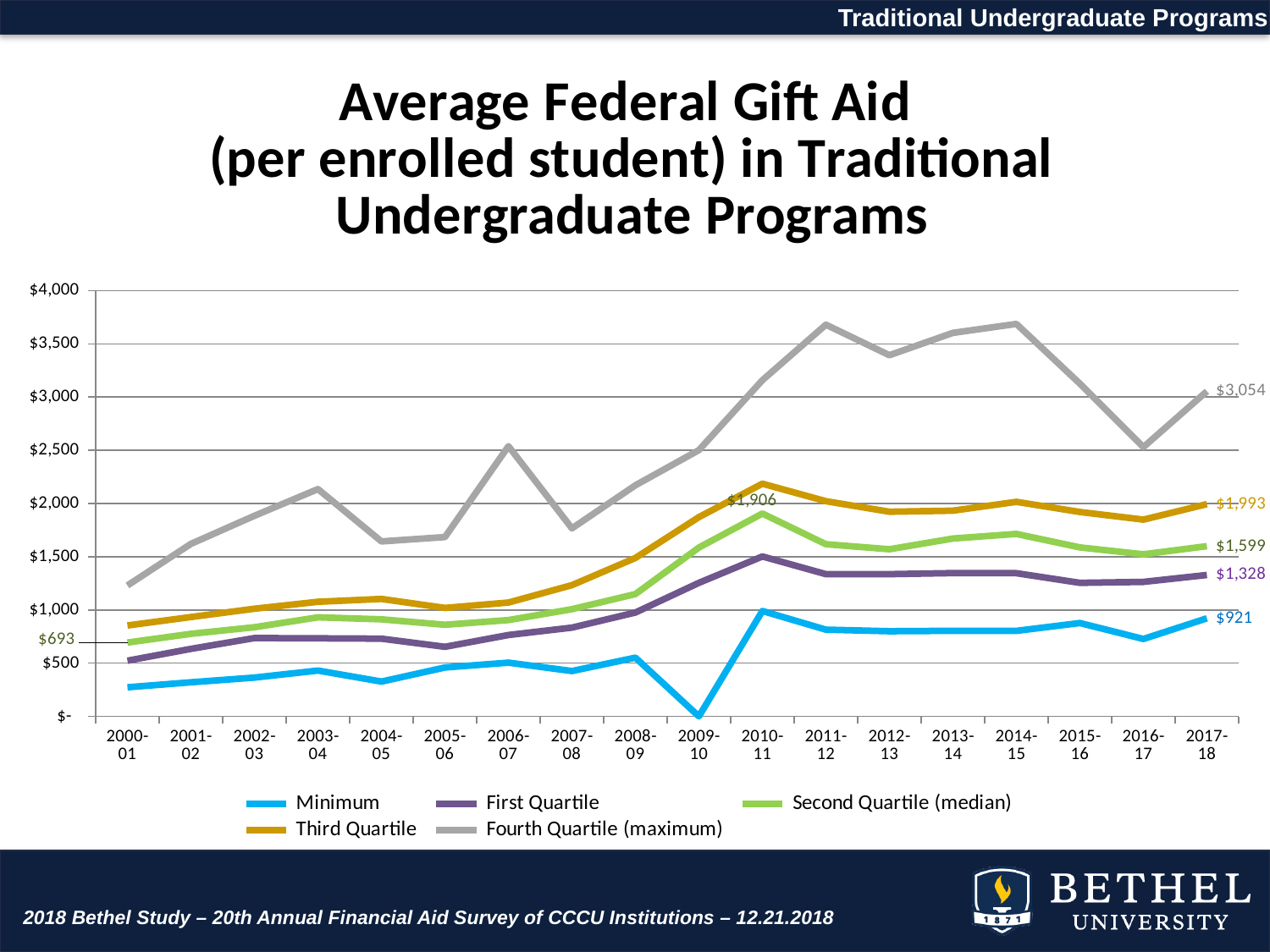
What is the Fourth Quartile (maximum) value for 2017-18? $3,054 By how much did the Second Quartile (median) increase from 2000-01 to 2010-11? $1,213 How many series does the legend list? 5 What is the difference between the Third Quartile and First Quartile values in 2017-18? $665 Is the Minimum value for 2009-10 greater or less than $500? less How many academic years are plotted along the x axis? 18 Which year has the larger Fourth Quartile (maximum) value, 2011-12 or 2012-13? 2011-12 What is the Second Quartile (median) value for 2000-01? $693 What is the Second Quartile (median) value for 2010-11? $1,906 What kind of chart is shown on the slide? line chart What is the Minimum value for 2017-18? $921 What is the Second Quartile (median) value for 2017-18? $1,599